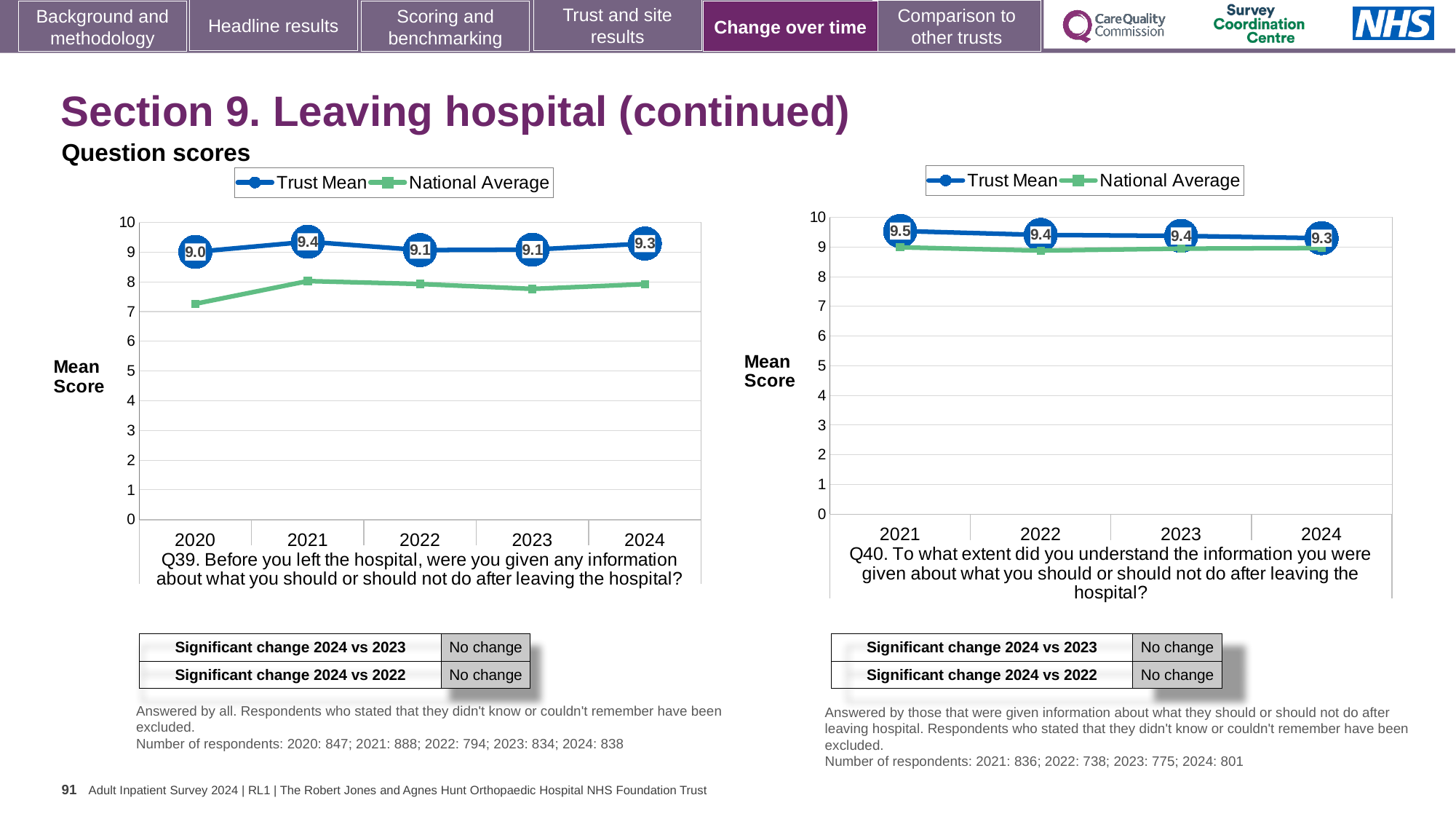
How many series does the legend of the Q40 chart on the right list? 2 In the Q39 chart on the left, what is the difference between the Trust Mean in 2021 and in 2020? 0.4 In the Q39 chart on the left, what is the Trust Mean for 2020? 9.0 In the Q40 chart on the right, does the Trust Mean rise or fall from 2021 to 2024? Fall How many years are shown on the x axis of the Q39 chart on the left? 5 In the Q40 chart on the right, what is the Trust Mean for 2024? 9.3 In the Q40 chart on the right, which year has the highest Trust Mean? 2021 What kind of chart is the Q40 chart on the right? Line chart In the Q39 chart on the left, what is the Trust Mean for 2021? 9.4 In the Q40 chart on the right, is the Trust Mean higher in 2021 or in 2024? 2021 In the Q39 chart on the left, is the National Average for 2020 greater or less than 8? less In the Q39 chart on the left, which year has the lowest Trust Mean? 2020